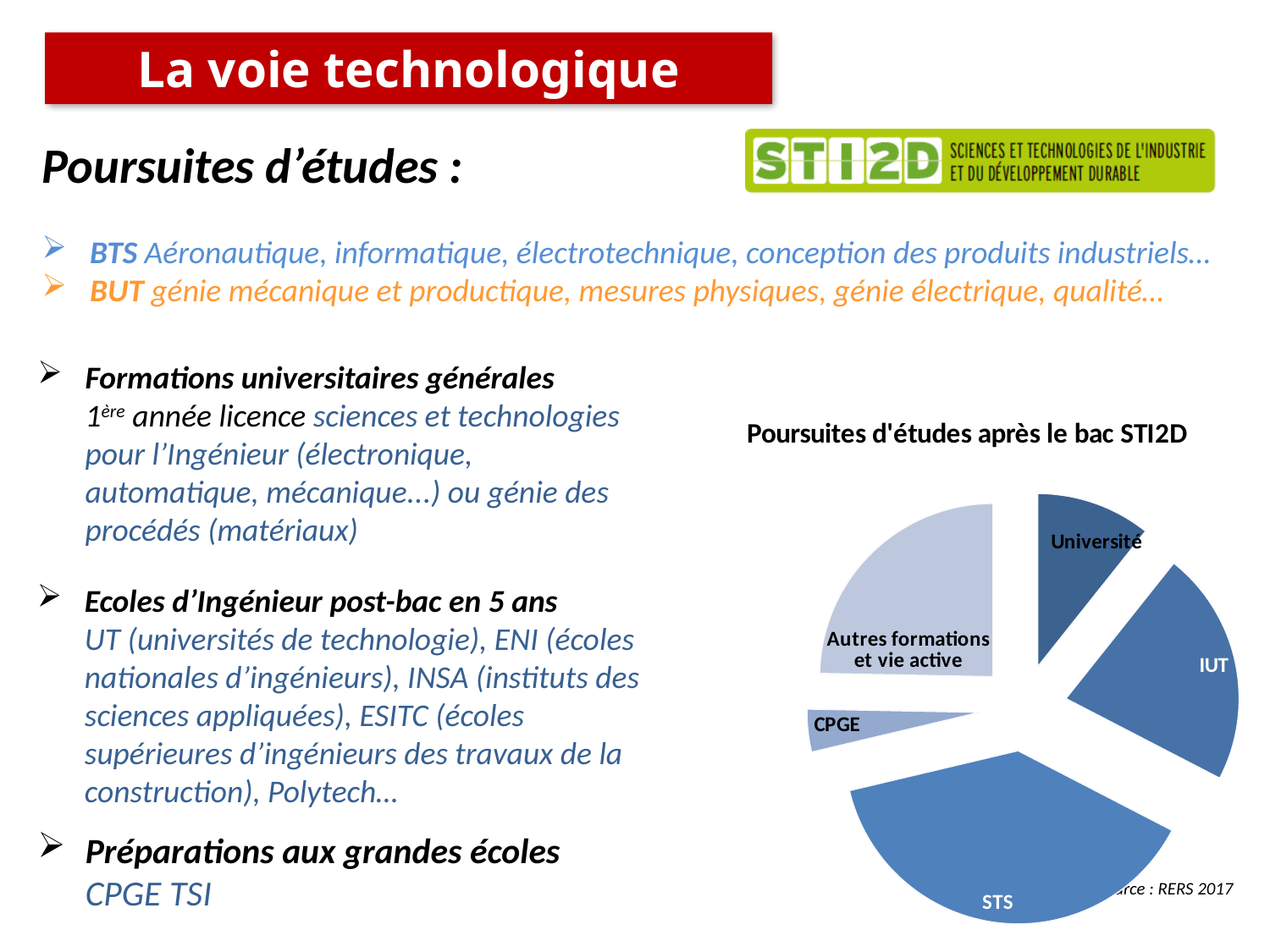
Which slice is larger in the pie chart, Autres formations et vie active or CPGE? Autres formations et vie active What kind of chart is shown on the slide? pie chart What is the title of the chart on the slide? Poursuites d'études après le bac STI2D Which category has the largest slice in the pie chart? STS Which slice is larger in the pie chart, STS or IUT? STS Which slice is larger in the pie chart, STS or Université? STS Which category has the smallest slice in the pie chart? CPGE How many slices does the pie chart have? 5 What source is cited below the pie chart? RERS 2017